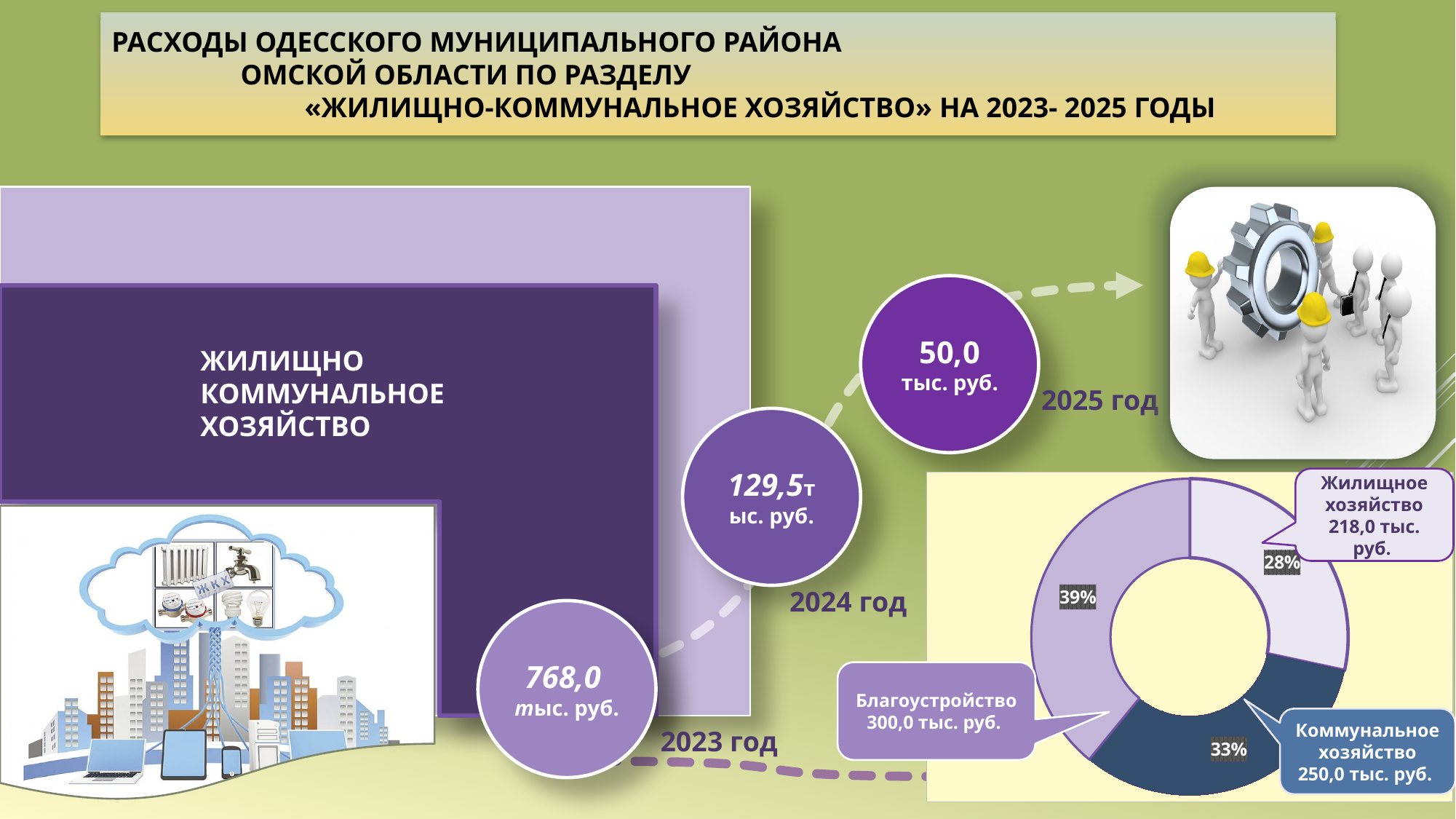
In the doughnut chart, what share does Благоустройство have? 39% In the doughnut chart, what is the difference between Благоустройство and Жилищное хозяйство in тыс. руб.? 82,0 тыс. руб. In the doughnut chart, what share does Жилищное хозяйство have? 28% In the doughnut chart, what share does Коммунальное хозяйство have? 33% In the doughnut chart, what is the value for Благоустройство? 300,0 тыс. руб. In the doughnut chart, which is larger: Коммунальное хозяйство or Жилищное хозяйство? Коммунальное хозяйство Which slice of the doughnut chart is the smallest? Жилищное хозяйство How many slices does the doughnut chart have? 3 In the doughnut chart, what is the value for Коммунальное хозяйство? 250,0 тыс. руб. Which slice of the doughnut chart is the largest? Благоустройство In the doughnut chart, what is the value for Жилищное хозяйство? 218,0 тыс. руб. What kind of chart is shown in the lower right of the slide? Doughnut (pie) chart